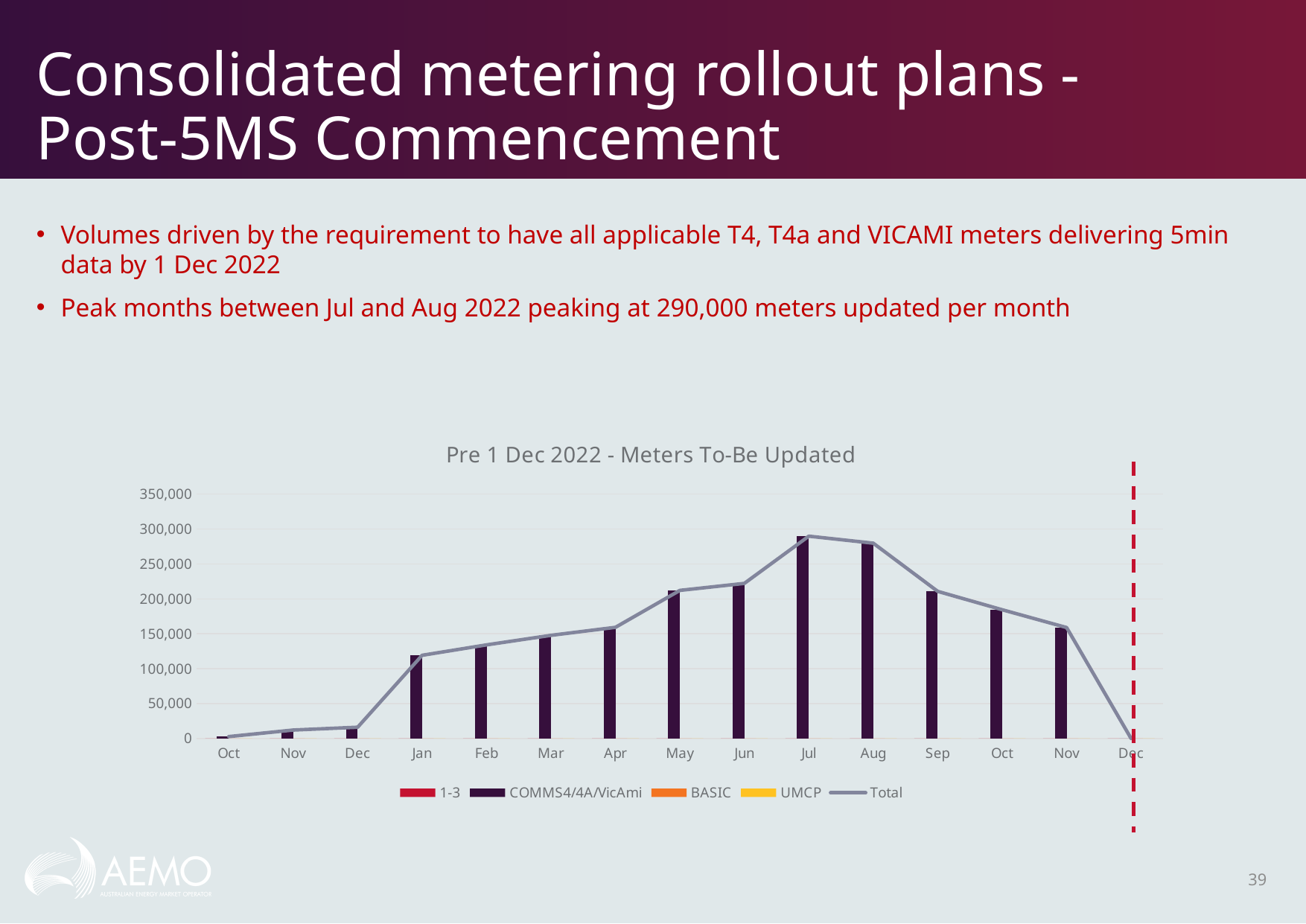
Is the value for May greater or less than 200,000? greater Is the value for Jul greater or less than 250,000? greater How many series does the chart legend list? 5 Which month has the highest number of meters to be updated? Jul Which is larger, the value for May or the value for the second Nov? May Is the value for the second Oct greater or less than 200,000? less What is the title of the chart? Pre 1 Dec 2022 - Meters To-Be Updated How many months are shown on the x axis of the chart? 15 What kind of chart is shown on the slide? bar chart with a line Do the values rise or fall from Jan to Jul? rise